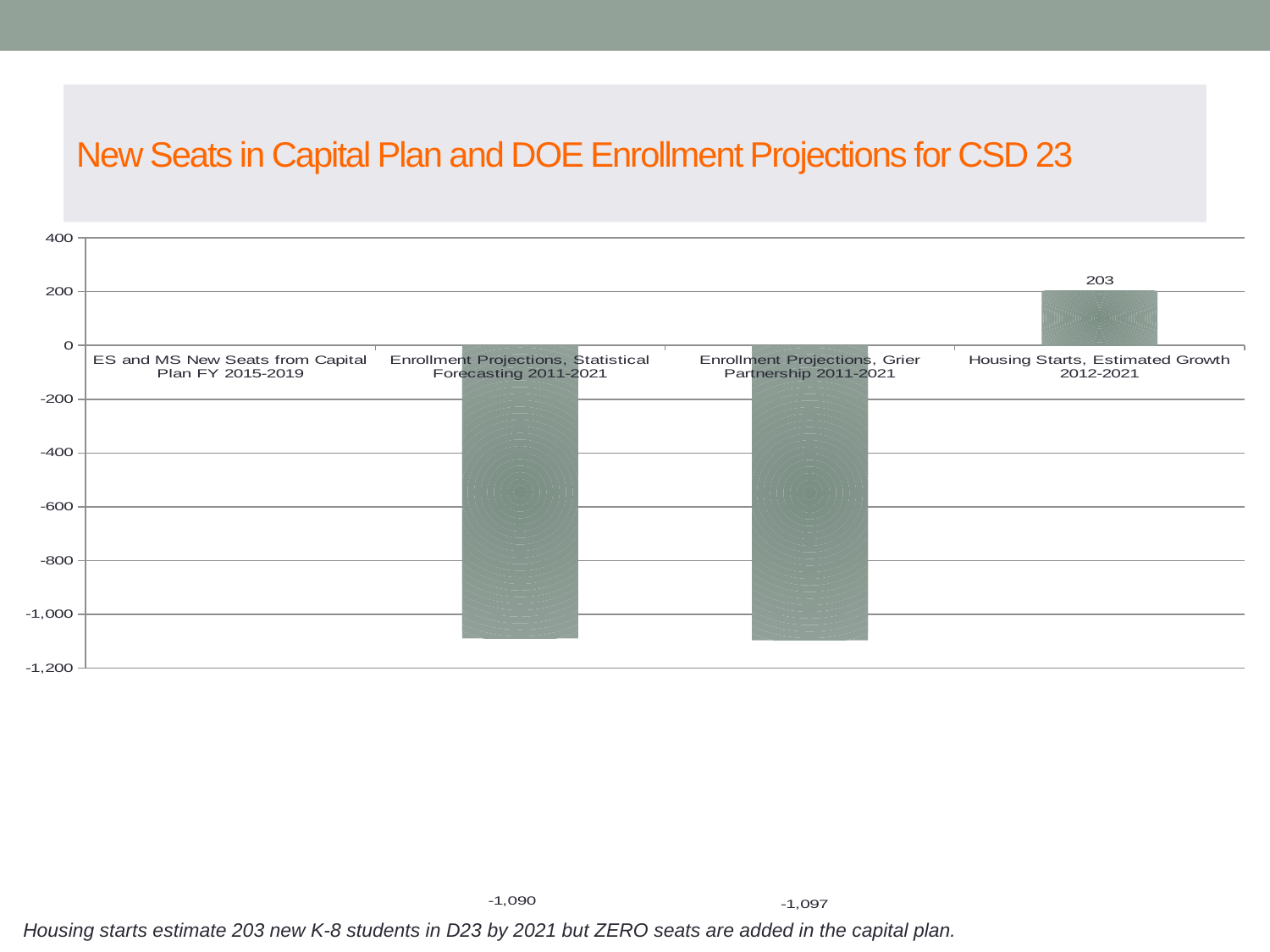
What kind of chart is shown on the slide? bar chart Which category has the lowest value? Enrollment Projections, Grier Partnership 2011-2021 What is the value for Enrollment Projections, Grier Partnership 2011-2021? -1,097 What is the title of the chart? New Seats in Capital Plan and DOE Enrollment Projections for CSD 23 What is the value for Housing Starts, Estimated Growth 2012-2021? 203 What is the difference between the Enrollment Projections, Statistical Forecasting 2011-2021 value and the Enrollment Projections, Grier Partnership 2011-2021 value? 7 What is the difference between the Housing Starts, Estimated Growth 2012-2021 value and the Enrollment Projections, Statistical Forecasting 2011-2021 value? 1,293 What is the value for Enrollment Projections, Statistical Forecasting 2011-2021? -1,090 Which category has the highest value? Housing Starts, Estimated Growth 2012-2021 Which is larger, the value for Housing Starts, Estimated Growth 2012-2021 or the value for Enrollment Projections, Grier Partnership 2011-2021? Housing Starts, Estimated Growth 2012-2021 Is the value for ES and MS New Seats from Capital Plan FY 2015-2019 greater or less than 200? less How many categories are shown on the x axis? 4